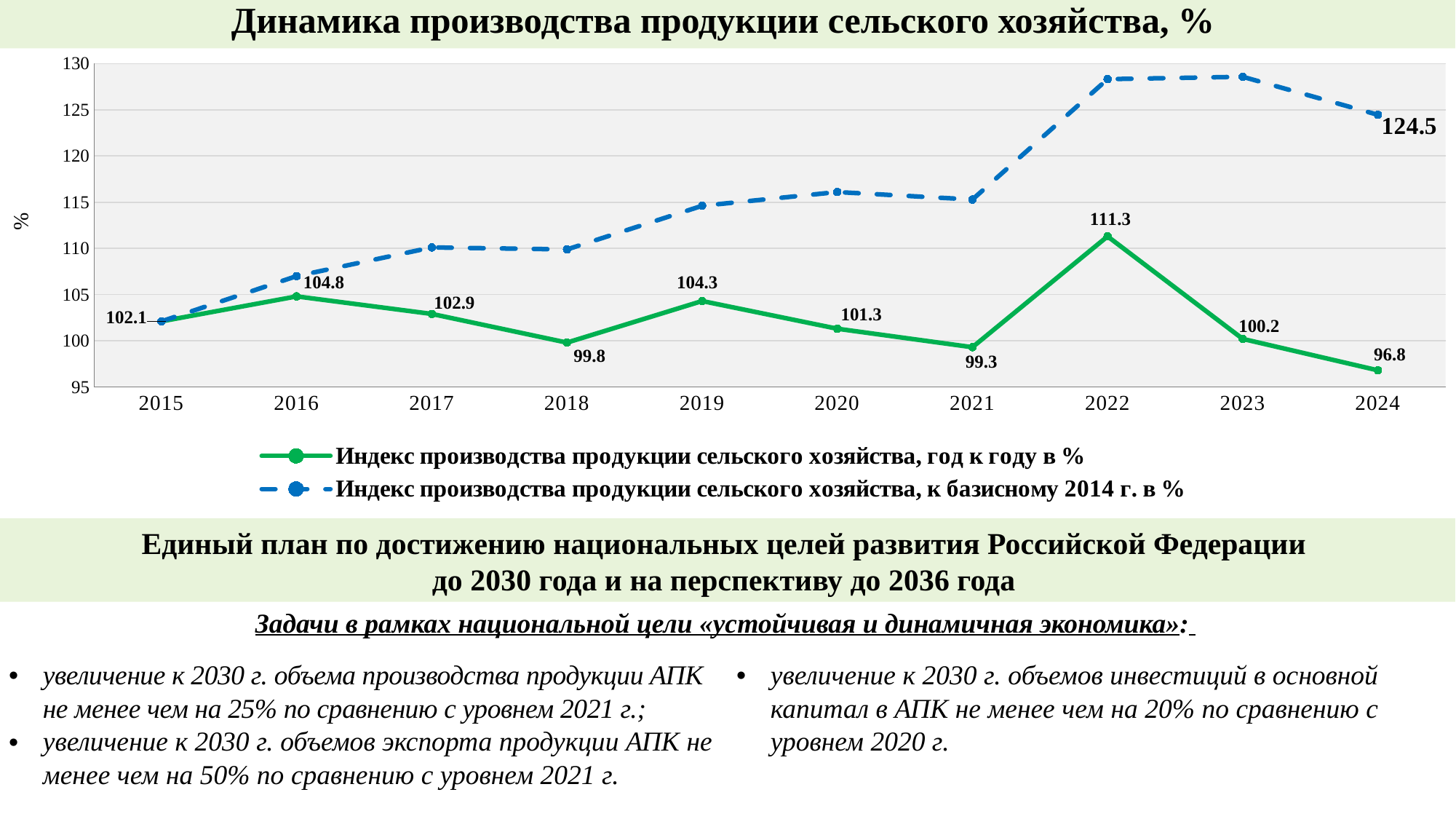
What is the value of the index relative to the 2014 base year in 2024? 124.5 How many years are shown on the x axis of the chart? 10 How many series does the legend list? 2 What type of chart is shown on the slide? Line chart Which year has a higher year-over-year index value, 2016 or 2019? 2016 Is the value of the index relative to the 2014 base year in 2022 greater or less than 125? greater What is the value of the year-over-year agricultural production index for 2022? 111.3 In which year is the year-over-year agricultural production index lowest? 2024 Is the value of the index relative to the 2014 base year in 2019 greater or less than 110? greater What is the year-over-year index value for 2018? 99.8 What is the difference between the year-over-year index values for 2022 and 2021? 12 In which year is the year-over-year agricultural production index highest? 2022